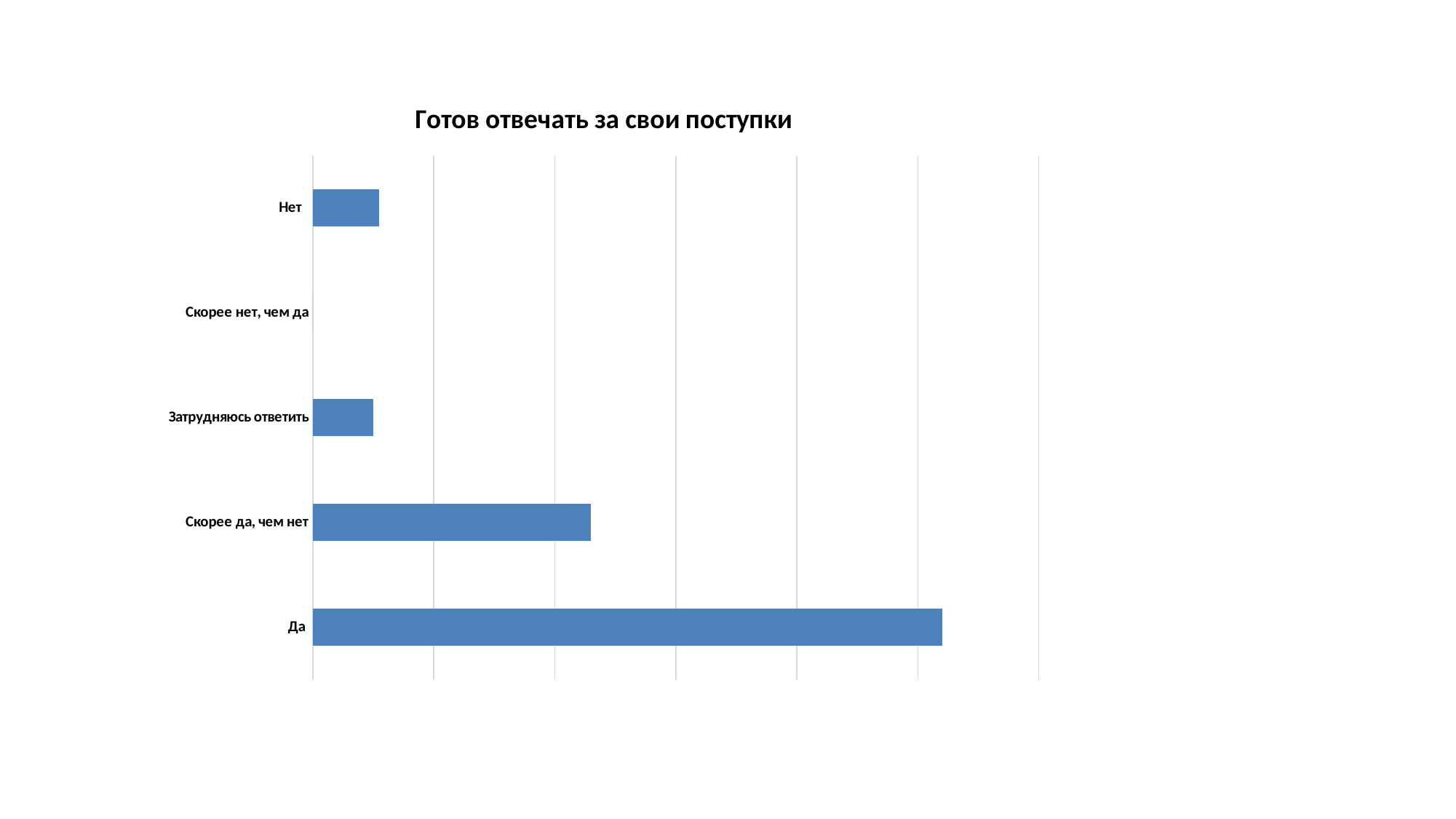
Which is larger, the value for Затрудняюсь ответить or the value for Скорее нет, чем да? Затрудняюсь ответить What kind of chart is shown on the slide? bar chart Which category has the highest value? Да Which category has the second-highest value? Скорее да, чем нет Are the bars on the chart horizontal or vertical? horizontal Which is larger, the value for Да or the value for Скорее да, чем нет? Да What is the title of the chart? Готов отвечать за свои поступки Which category has the lowest value? Скорее нет, чем да What colour are the bars on the chart? blue How many categories are shown on the chart? 5 Which is larger, the value for Скорее да, чем нет or the value for Нет? Скорее да, чем нет